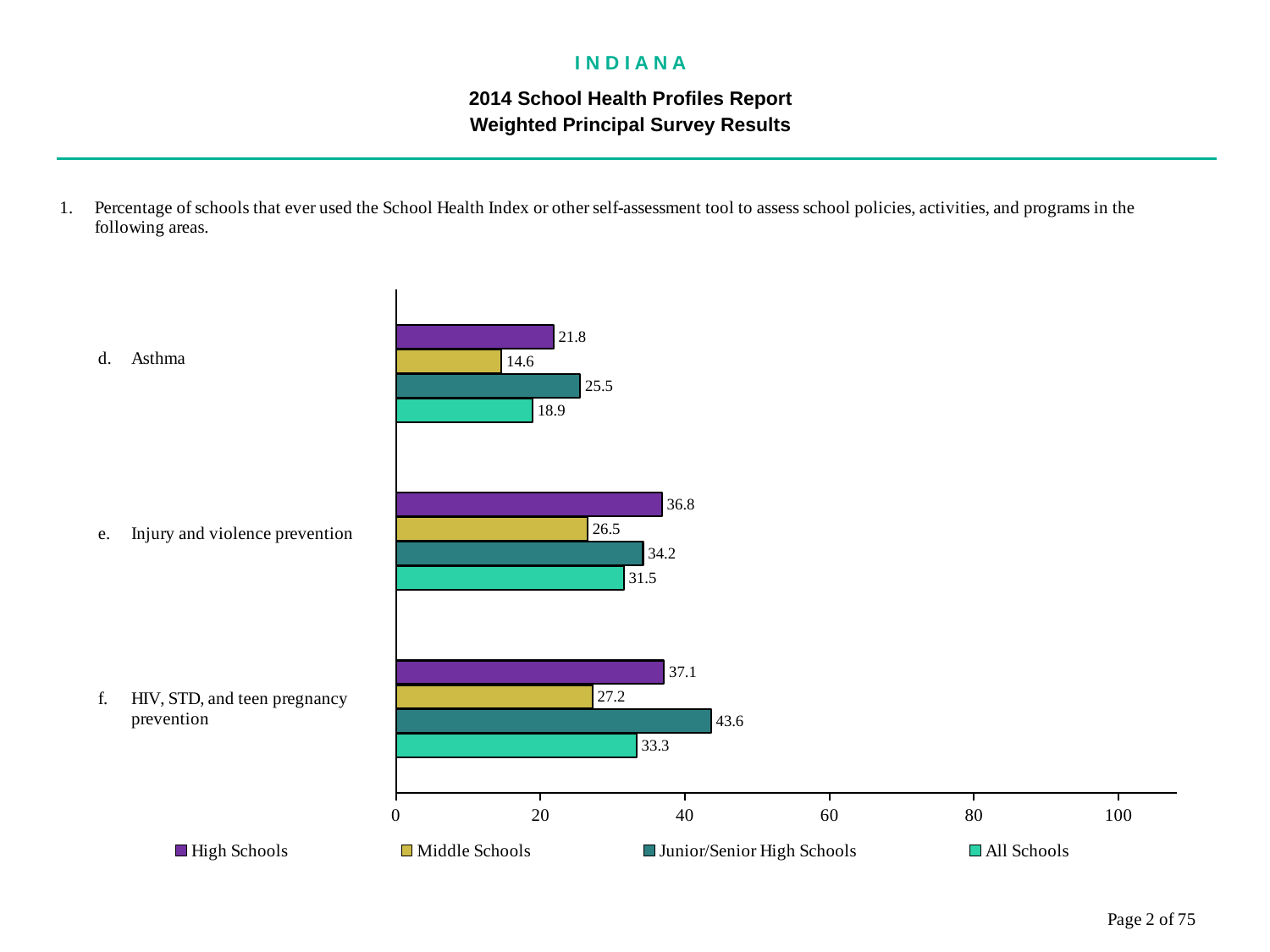
How many series does the legend list? 4 What is the value for Junior/Senior High Schools in the HIV, STD, and teen pregnancy prevention category? 43.6 How many categories are shown on the chart? 3 Which category has the highest value for Junior/Senior High Schools? HIV, STD, and teen pregnancy prevention What is the value for High Schools in the Asthma category? 21.8 What is the difference between the High Schools and Middle Schools values in the Injury and violence prevention category? 10.3 What kind of chart is shown on the slide? bar chart Which category has the lowest value for Middle Schools? Asthma Which is larger in the HIV, STD, and teen pregnancy prevention category: the value for High Schools or the value for Junior/Senior High Schools? Junior/Senior High Schools What is the value for All Schools in the Asthma category? 18.9 Is the value for All Schools in the Injury and violence prevention category greater or less than 40? less What is the value for Middle Schools in the Injury and violence prevention category? 26.5